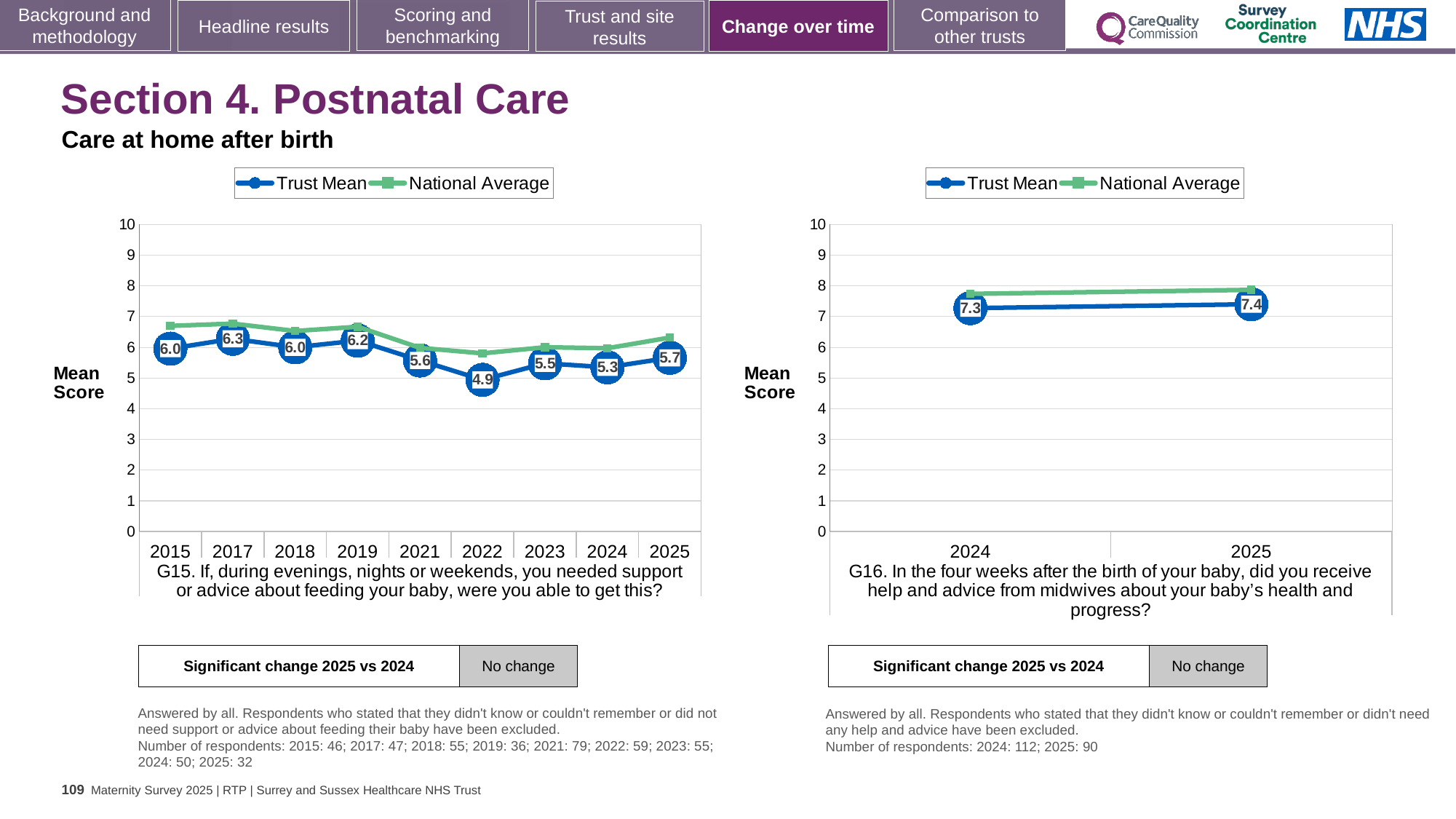
In the left chart (G15), which year has the highest Trust Mean score? 2017 In the left chart (G15), what is the Trust Mean score for 2022? 4.9 How many years are shown on the x axis of the left chart (G15)? 9 In the left chart (G15), which year has the lowest Trust Mean score? 2022 In the left chart (G15), what is the Trust Mean score for 2017? 6.3 In the right chart (G16), what is the Trust Mean score for 2025? 7.4 What type of chart is the left chart (G15)? Line chart How many series does the legend of the right chart (G16) list? 2 In the left chart (G15), what is the difference between the Trust Mean scores for 2025 and 2024? 0.4 In the right chart (G16), what is the difference between the Trust Mean scores for 2025 and 2024? 0.1 In the left chart (G15), is the Trust Mean score for 2019 higher or lower than for 2021? higher In the right chart (G16), is the National Average for 2024 greater or less than 7? greater